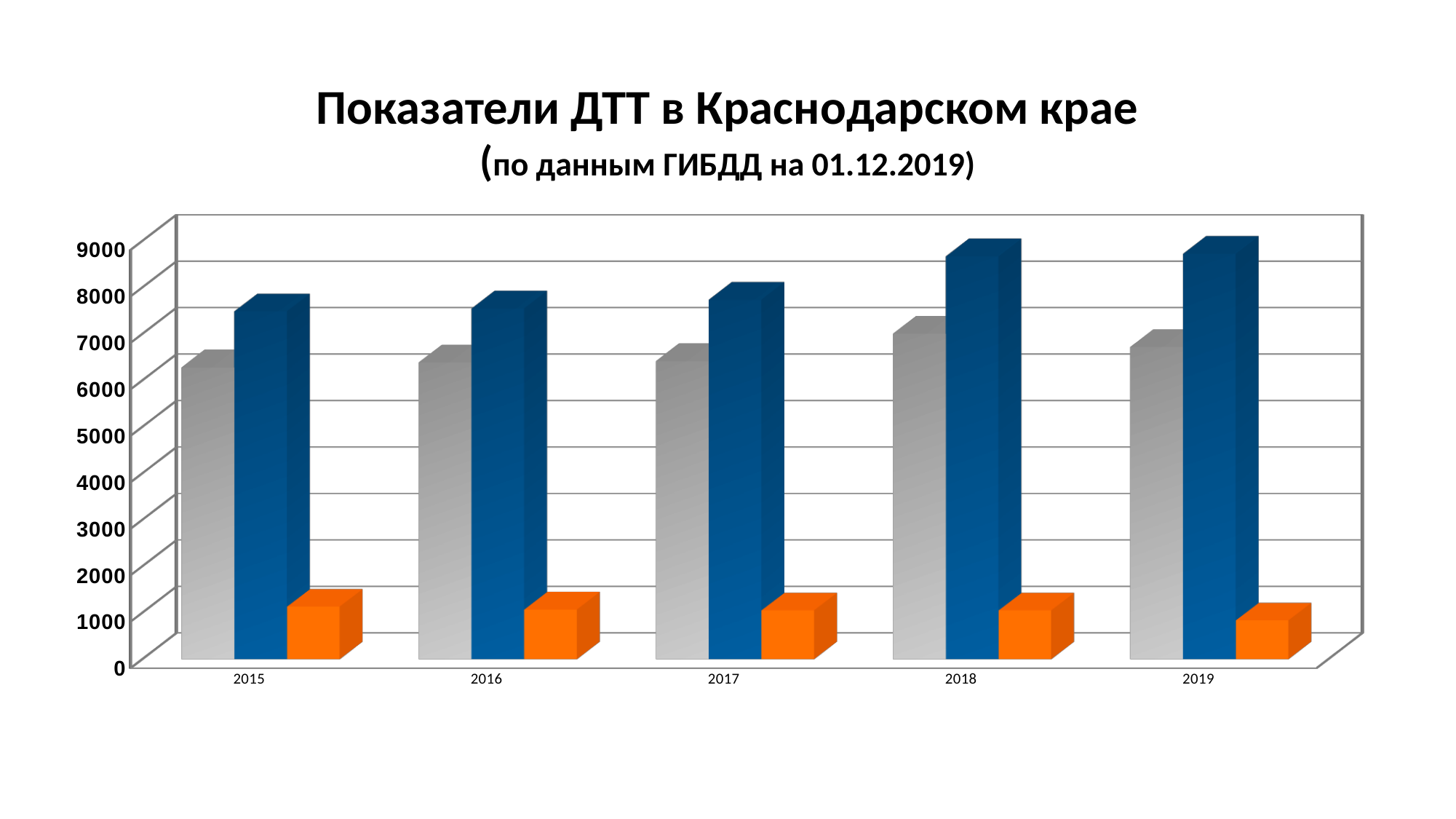
What kind of chart is shown on the slide? bar chart Which is larger: the blue bar for 2018 or the blue bar for 2015? the blue bar for 2018 Do the blue bars rise or fall from 2015 to 2018? rise Is the value of the grey bar for 2015 greater or less than 7000? less Is the value of the orange bar for 2015 greater or less than 2000? less What is the title of the chart? Показатели ДТТ в Краснодарском крае (по данным ГИБДД на 01.12.2019) How many bars are plotted for each year in the chart? 3 Which is larger in 2017: the blue bar or the grey bar? the blue bar How many years are shown on the x axis of the chart? 5 Is the value of the blue bar for 2018 greater or less than 8000? greater Which is larger in 2016: the grey bar or the orange bar? the grey bar